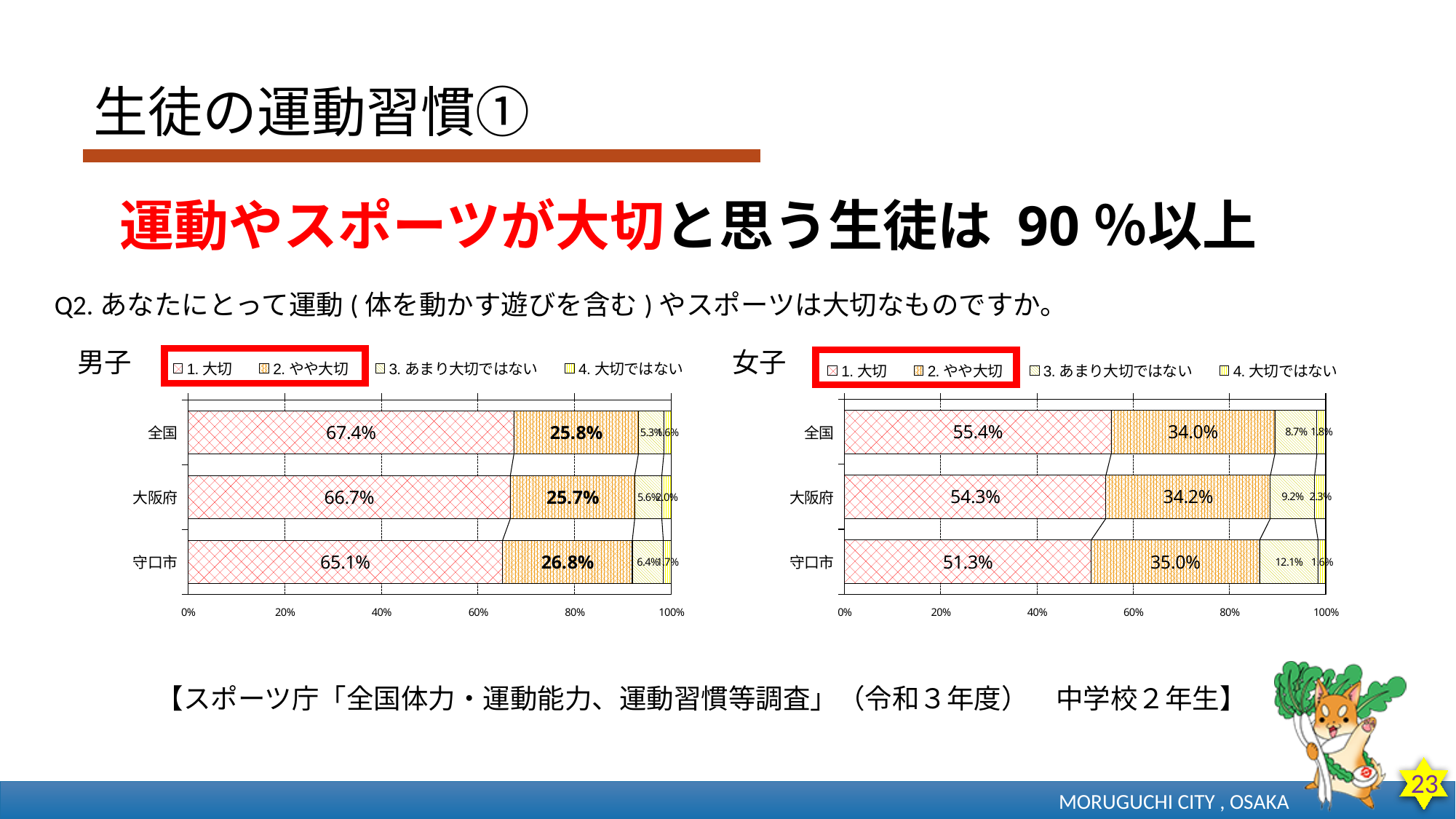
In the 女子 chart on the right, what is the value of 1. 大切 for 守口市? 51.3% How many series does the legend of the 女子 chart on the right list? 4 In the 男子 chart on the left, what is the value of 2. やや大切 for 守口市? 26.8% In the 女子 chart on the right, what is the value of 3. あまり大切ではない for 大阪府? 9.2% In the 男子 chart on the left, which category has the highest value for 1. 大切? 全国 In the 女子 chart on the right, is the 1. 大切 value for 大阪府 greater or less than 60%? less How many categories are shown on the y axis of the 男子 chart on the left? 3 In the 男子 chart on the left, which is larger: the 2. やや大切 value for 守口市 or for 大阪府? 守口市 In the 女子 chart on the right, what is the difference between the 1. 大切 values for 全国 and 守口市? 4.1% In the 男子 chart on the left, what is the value of 1. 大切 for 全国? 67.4% What type of chart is the 男子 chart on the left? Stacked bar chart In the 女子 chart on the right, which category has the lowest value for 1. 大切? 守口市